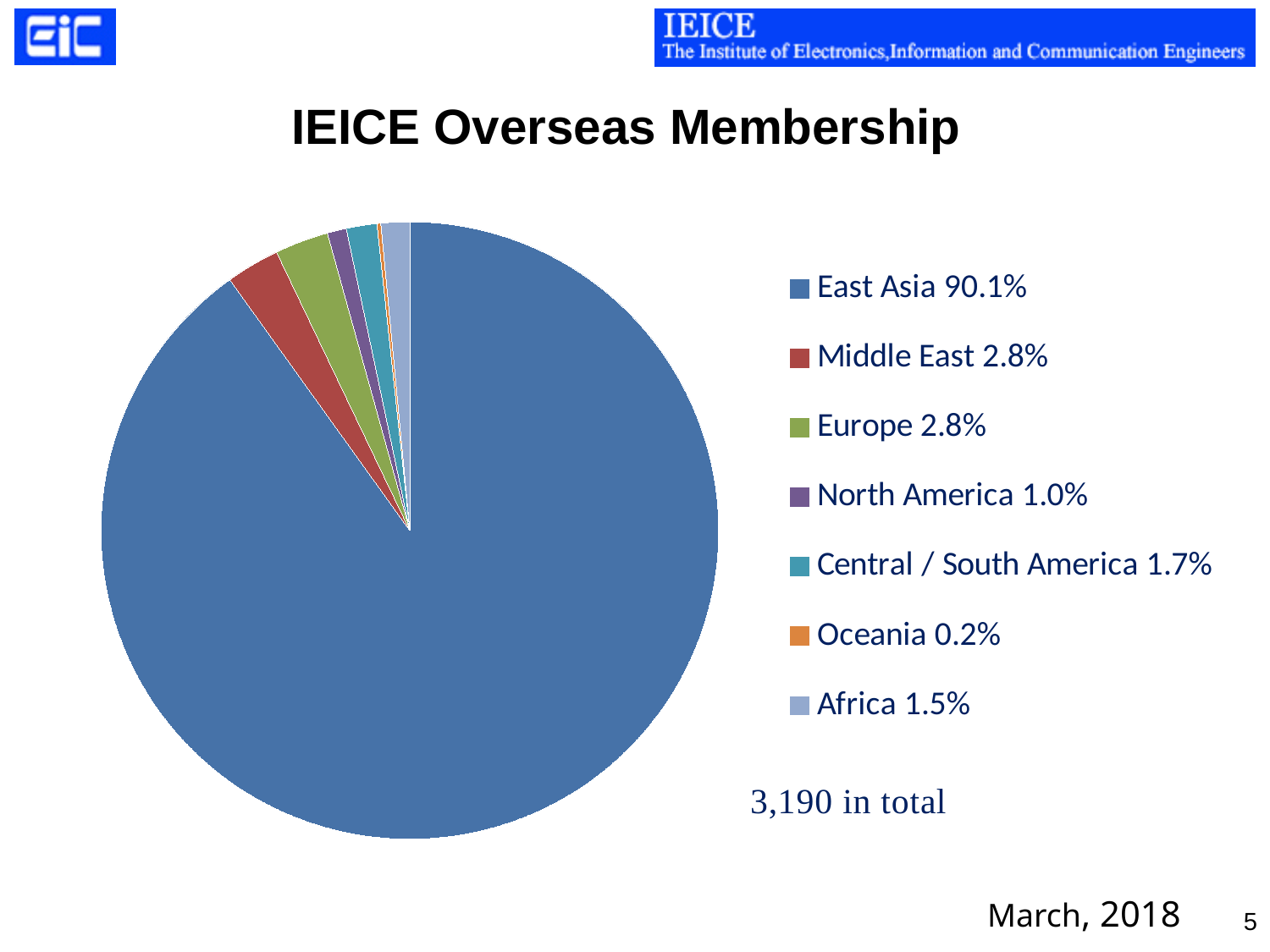
What is the difference in percentage points between the East Asia share and the Middle East share? 87.3 What share of IEICE overseas membership is from Africa? 1.5% What share of IEICE overseas membership is from East Asia? 90.1% Which region has the smallest share of IEICE overseas membership? Oceania What share of IEICE overseas membership is from Central / South America? 1.7% Which has a larger share, North America or Africa? Africa What is the total number of overseas members stated on the slide? 3,190 What type of chart is shown on the slide? pie chart How many regions are shown in the pie chart? 7 What is the title of the chart? IEICE Overseas Membership Which region has the largest share of IEICE overseas membership? East Asia